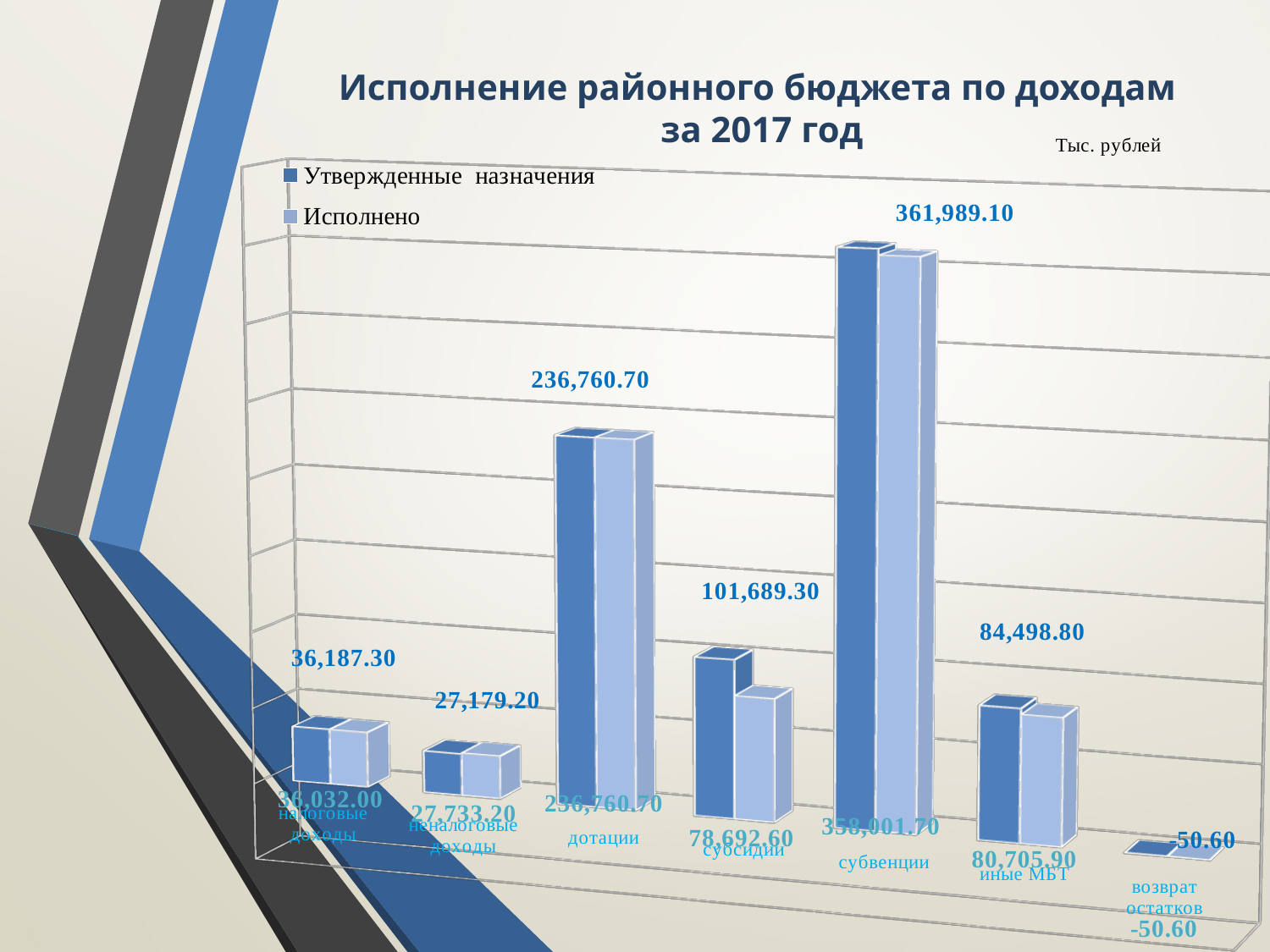
For неналоговые доходы, which is larger: Утвержденные назначения or Исполнено? Исполнено How many series does the legend list? 2 Which category has the highest value for Утвержденные назначения? субвенции What is the value of Исполнено for субсидии? 78,692.60 Which category has the lowest value for Исполнено? возврат остатков In what units are the values on the chart expressed? Тыс. рублей What is the difference between Утвержденные назначения and Исполнено for субсидии? 22,996.70 What kind of chart is shown on the slide? bar chart What is the value of Утвержденные назначения for субвенции? 361,989.10 What is the value of Исполнено for иные МБТ? 80,705.90 What is the difference between Утвержденные назначения and Исполнено for субвенции? 3,987.40 How many categories are plotted along the x axis? 7